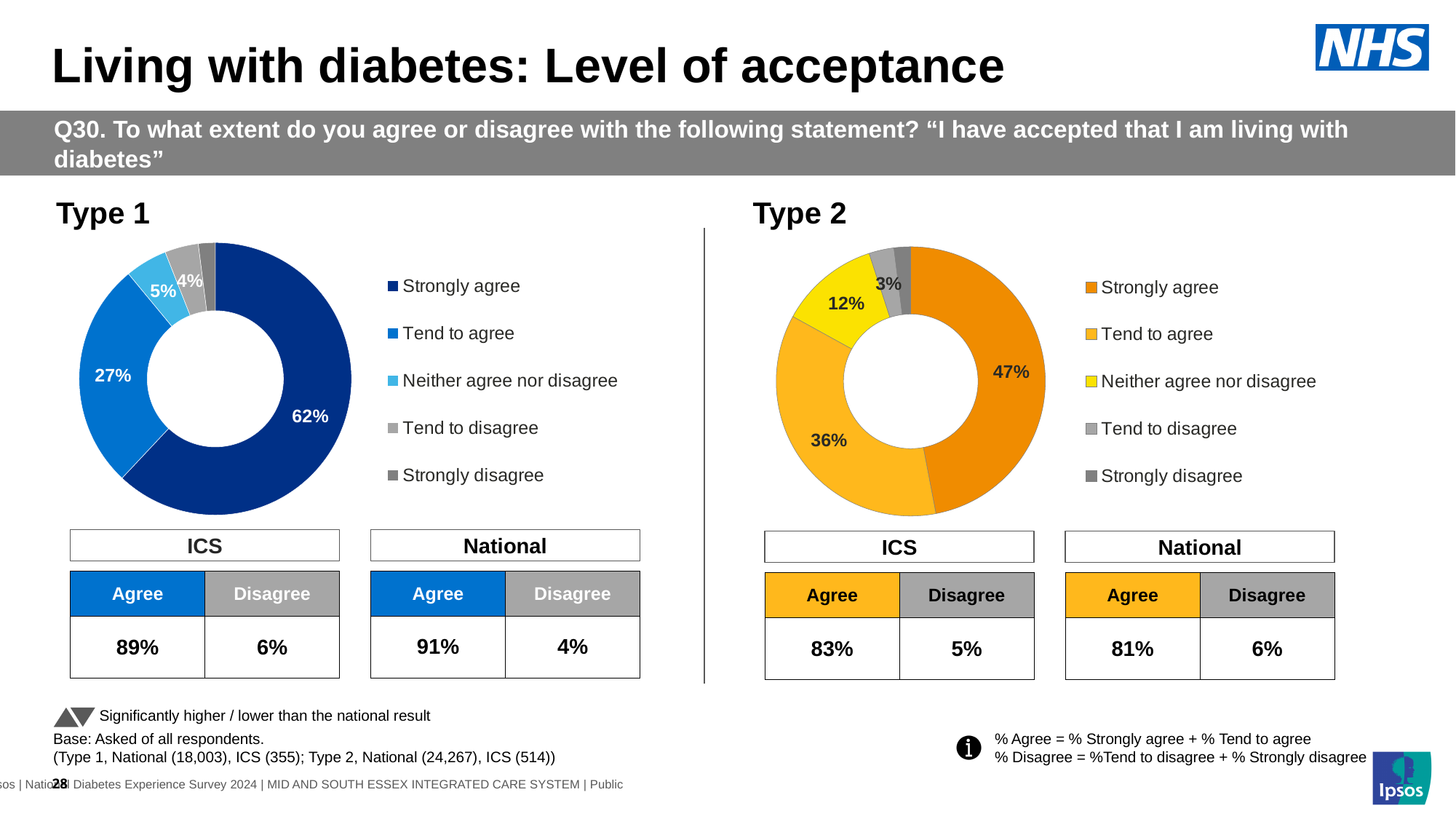
In the Type 2 chart, which category has the largest share? Strongly agree What kind of chart is used for Type 1? Donut (pie) chart How many categories does the legend of the Type 1 chart list? 5 In the Type 2 chart, which is larger: Tend to agree or Neither agree nor disagree? Tend to agree In the Type 2 chart, what percentage of respondents tend to disagree? 3% In the Type 1 chart, what is the combined share of Strongly agree and Tend to agree? 89% In the Type 2 chart, what percentage of respondents neither agree nor disagree? 12% In the Type 1 chart, what percentage of respondents strongly agree? 62% In the Type 1 chart, what percentage of respondents tend to agree? 27% In the Type 1 chart, which category has the largest share? Strongly agree What is the difference between the Strongly agree share in the Type 1 chart and the Strongly agree share in the Type 2 chart? 15% In the Type 2 chart, what percentage of respondents strongly agree? 47%